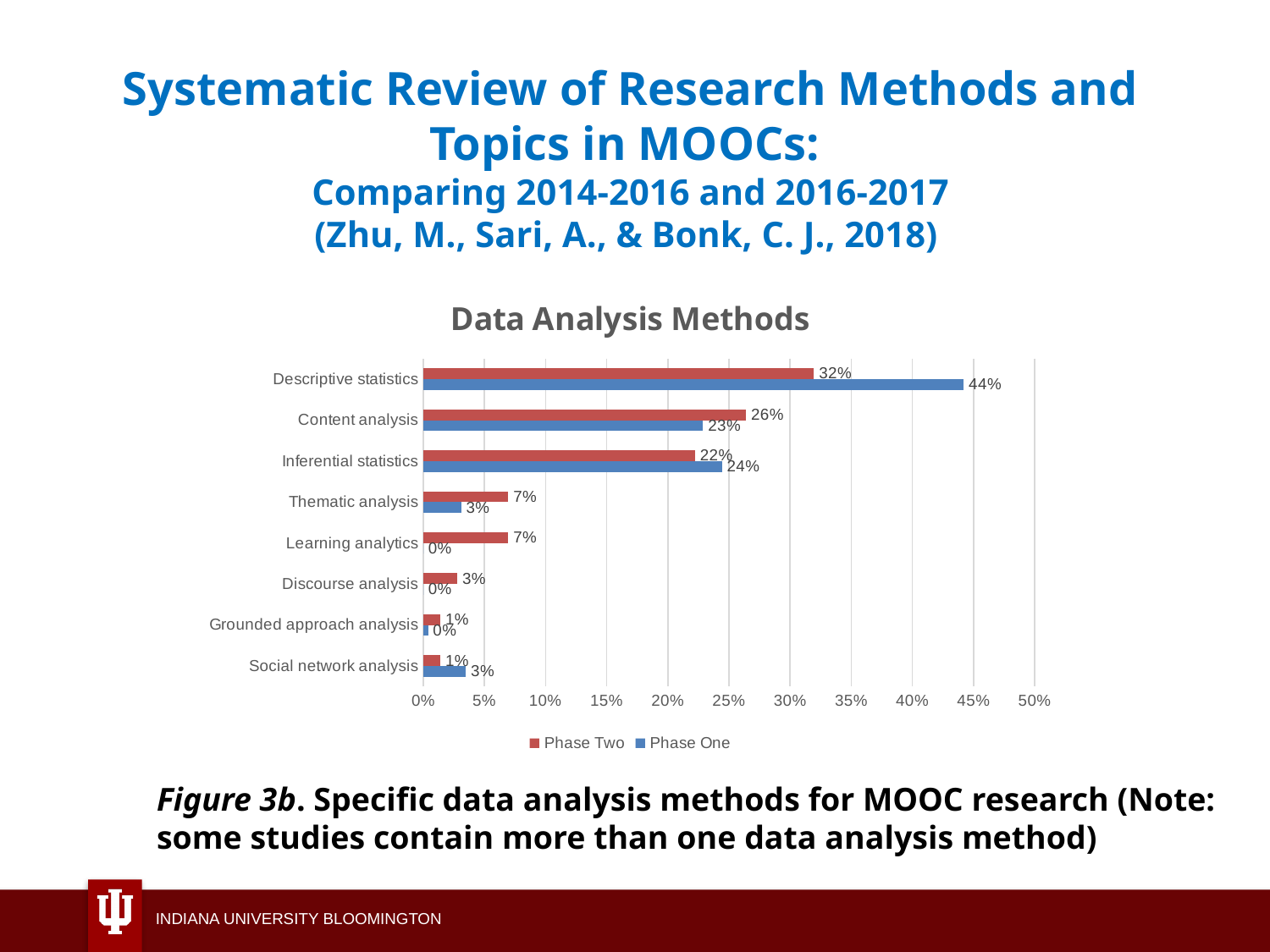
Which data analysis method has the highest Phase Two value? Descriptive statistics What is the Phase One value for Inferential statistics? 24% What is the Phase One value for Descriptive statistics? 44% What is the Phase Two value for Content analysis? 26% Which data analysis method has the highest Phase One value? Descriptive statistics How many series does the legend list? 2 Which is larger for Content analysis, the Phase One value or the Phase Two value? Phase Two What is the Phase Two value for Learning analytics? 7% What is the difference between the Phase One and Phase Two values for Descriptive statistics? 12% What kind of chart is shown? Bar chart What is the title of the chart? Data Analysis Methods How many data analysis methods are listed on the chart? 8